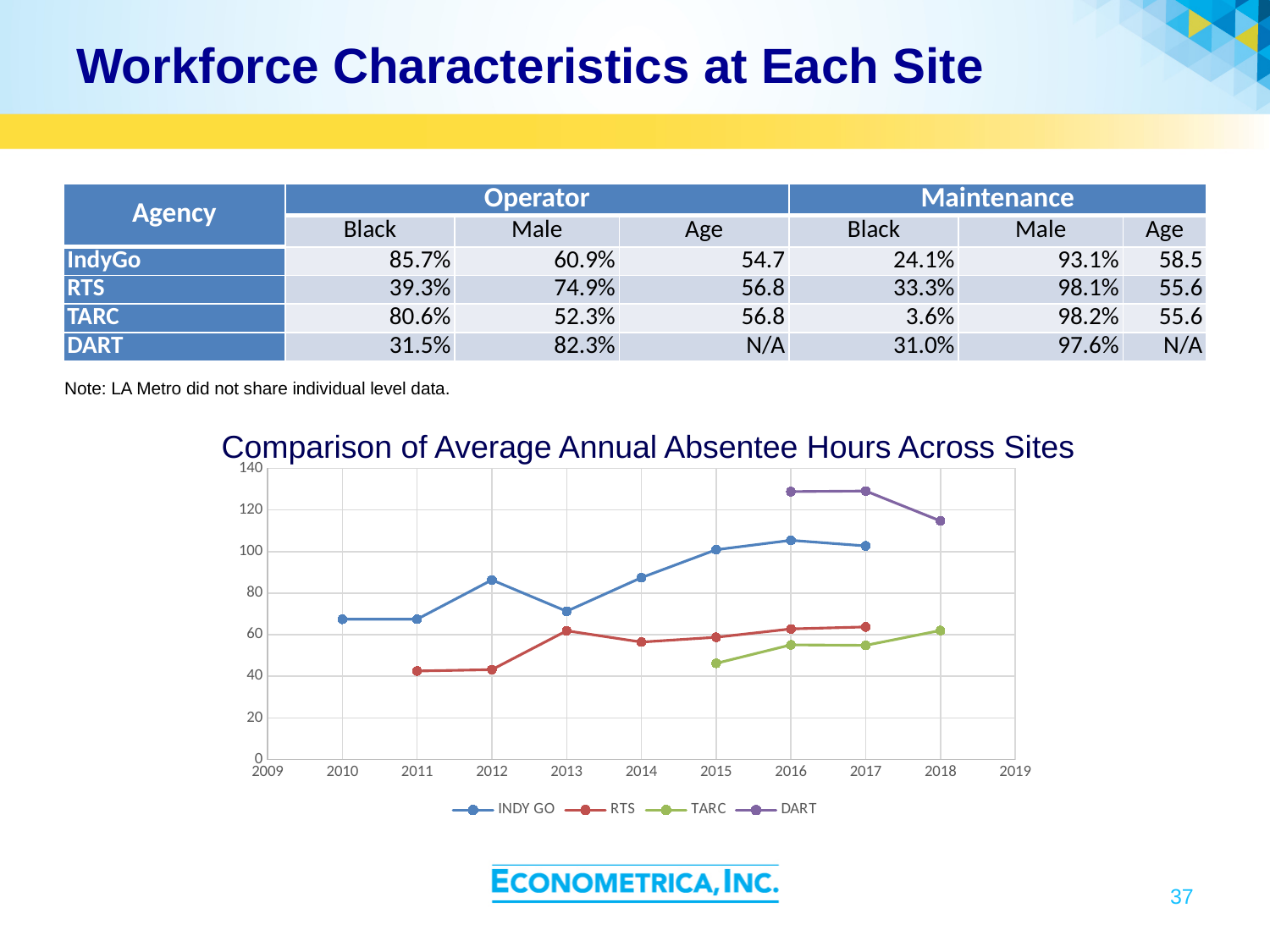
How many series does the legend of the chart list? 4 Is the value for DART in 2018 greater or less than 100? greater Is the value for TARC in 2015 greater or less than 60? less Is the value for DART in 2016 greater or less than 120? greater Which series has the lowest value in 2017? TARC In 2013, which series has the larger value, INDY GO or RTS? INDY GO Do the values for INDY GO rise or fall from 2013 to 2016? rise How many data points are plotted for the DART series? 3 What is the title of the chart on the slide? Comparison of Average Annual Absentee Hours Across Sites Which series has the highest value in 2017? DART What kind of chart is shown on the slide? line chart